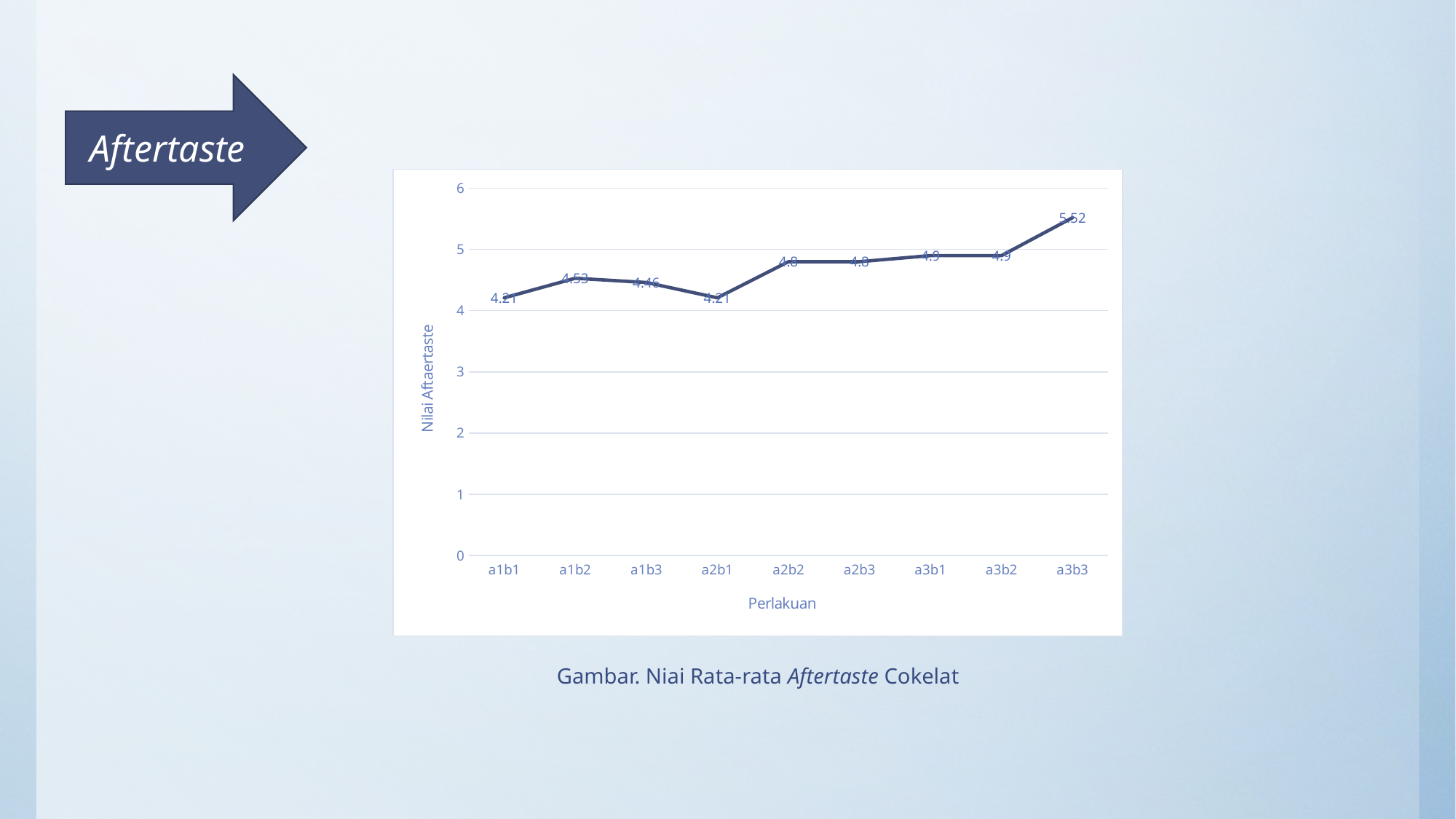
What is the value for a2b2? 4.8 What is the value for a1b3? 4.46 How many treatments are plotted on the x axis? 9 What is the value for a1b2? 4.53 What is the value for a3b3? 5.52 What is the difference between the values for a3b3 and a1b1? 1.31 Which is larger, the value for a1b2 or the value for a2b1? a1b2 What is the label of the y axis? Nilai Aftaertaste What is the label of the x axis? Perlakuan Is the value for a3b3 greater or less than 5? greater Which treatment (perlakuan) has the highest value? a3b3 What type of chart is shown on the slide? line chart